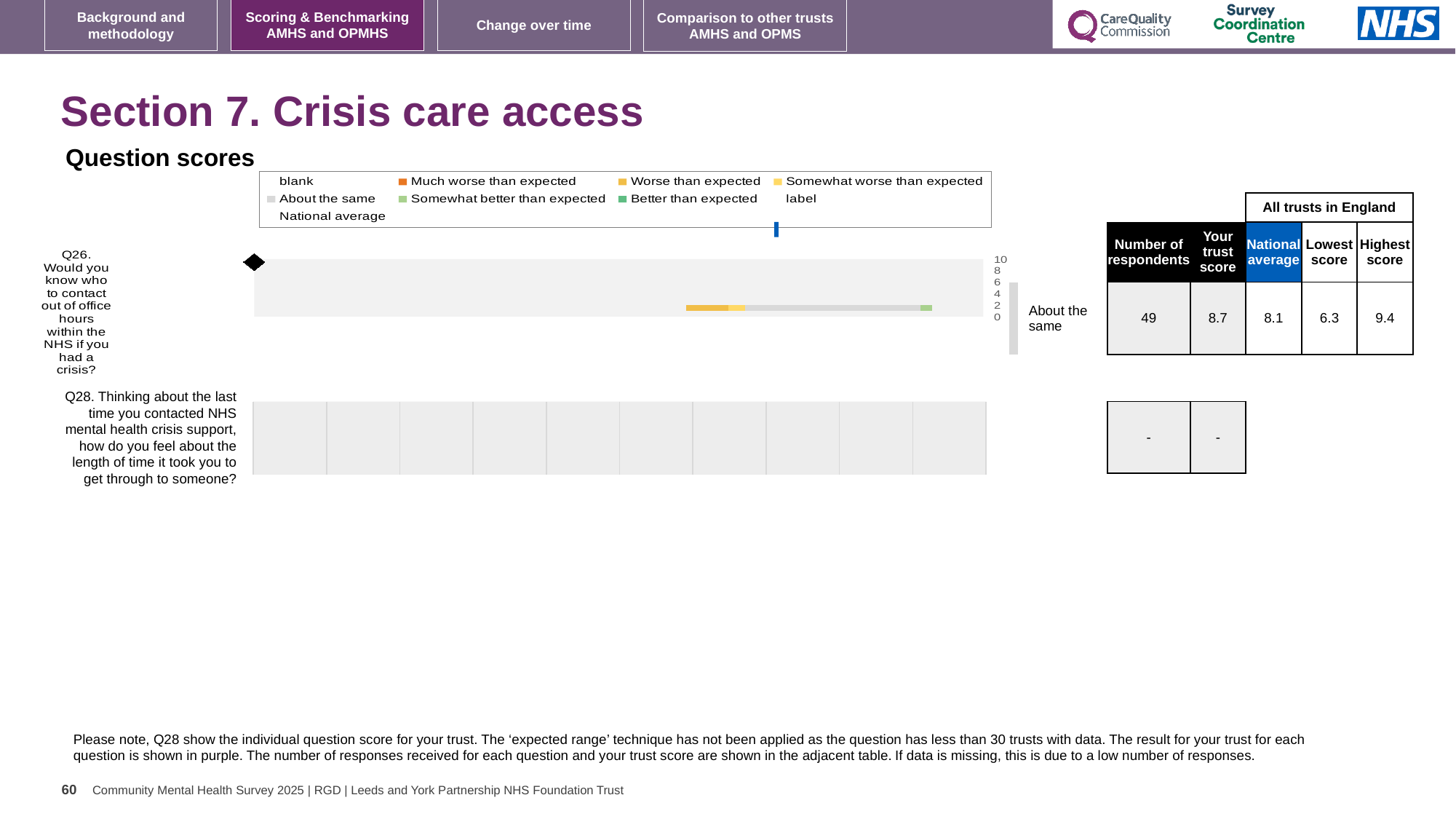
What is the trust score shown for Q26 (Would you know who to contact out of office hours within the NHS if you had a crisis)? 8.7 How many respondents are shown for Q26? 49 What is the highest score across all trusts in England for Q26? 9.4 What kind of chart is used to show the question scores? Bar chart What is the difference between the trust score and the national average for Q26? 0.6 What is the national average score shown for Q26? 8.1 What is the difference between the highest and lowest trust scores in England for Q26? 3.1 What benchmark category label is shown next to the Q26 bar? About the same For Q26, which is larger: the trust score or the national average? Trust score What is the lowest score across all trusts in England for Q26? 6.3 Is the trust score for Q26 greater or less than 8? greater